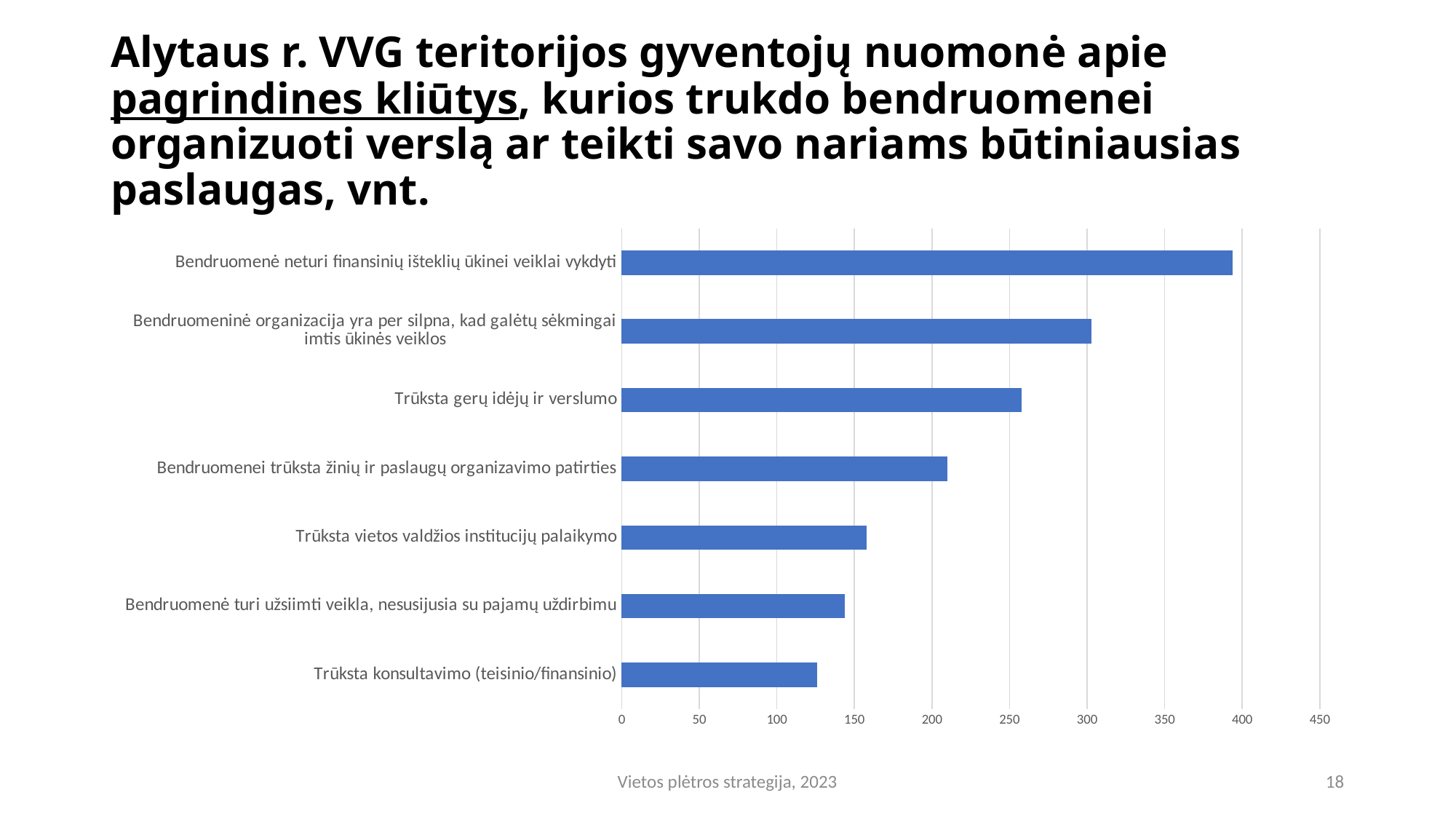
Is the value for 'Trūksta konsultavimo (teisinio/finansinio)' greater or less than 150? less Is the value for 'Bendruomenė neturi finansinių išteklių ūkinei veiklai vykdyti' greater or less than 350? greater What kind of chart is shown on the slide? bar chart How many categories (obstacles) are plotted in the chart? 7 Is the value for 'Trūksta gerų idėjų ir verslumo' greater or less than 300? less What is the highest value shown on the horizontal axis of the chart? 450 Which has a larger value: 'Trūksta gerų idėjų ir verslumo' or 'Bendruomenė turi užsiimti veikla, nesusijusia su pajamų uždirbimu'? Trūksta gerų idėjų ir verslumo Which category has the highest value? Bendruomenė neturi finansinių išteklių ūkinei veiklai vykdyti Which category has the lowest value? Trūksta konsultavimo (teisinio/finansinio)